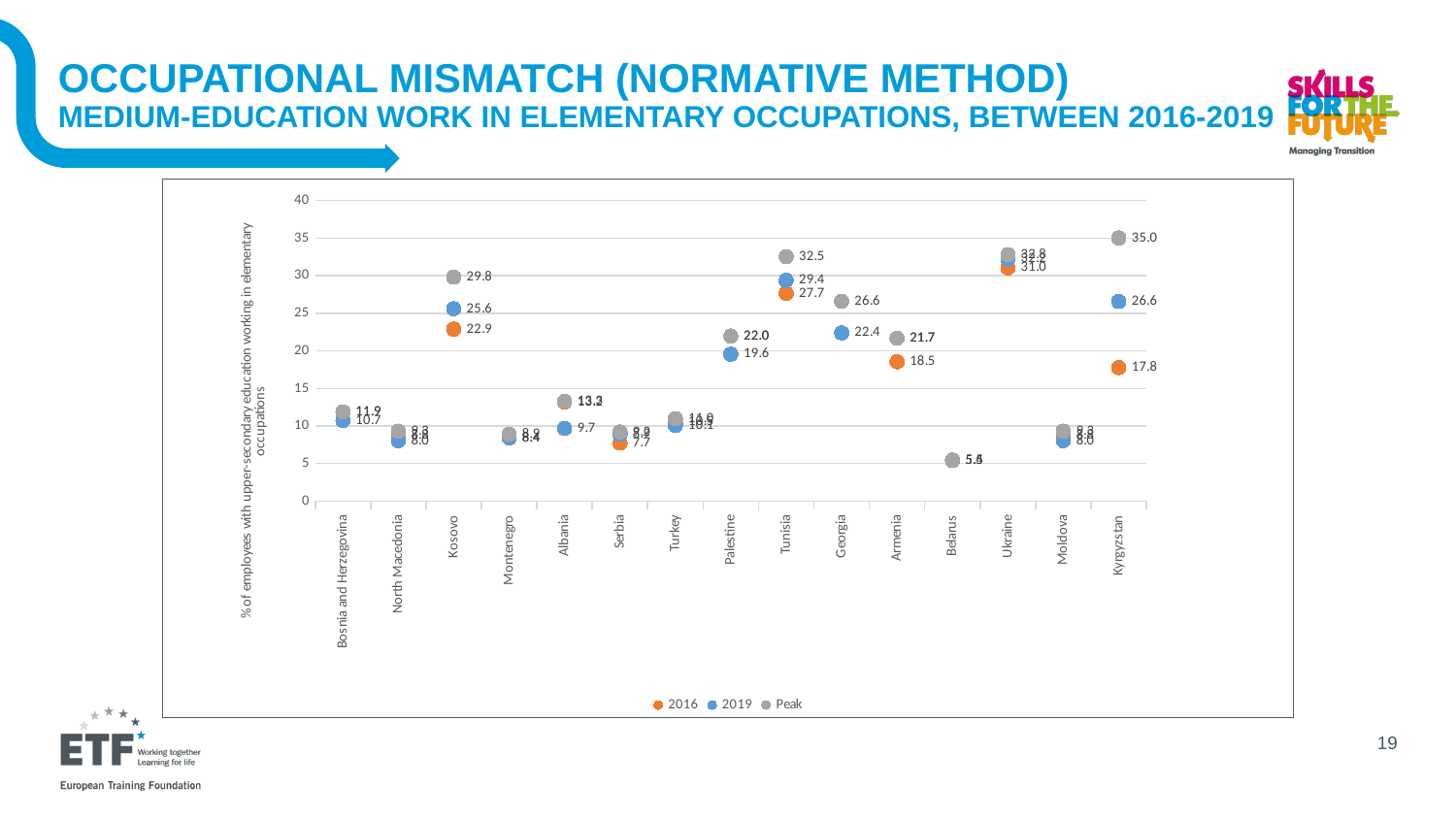
What is the difference between the 2019 and 2016 values for Kyrgyzstan? 8.8 Which is larger, the 2019 value for Kosovo or the 2019 value for Tunisia? Tunisia What is the 2016 value for Tunisia? 27.7 What is the Peak value for Kosovo? 29.8 What is the 2016 value for Armenia? 18.5 How many series does the legend list? 3 Is the value for Belarus greater or less than 10? less What is the 2019 value for Kyrgyzstan? 26.6 Which country has the lowest values on the chart? Belarus What is the 2019 value for Palestine? 19.6 Which country has the highest Peak value? Kyrgyzstan What is the difference between the Peak and 2016 values for Kosovo? 6.9